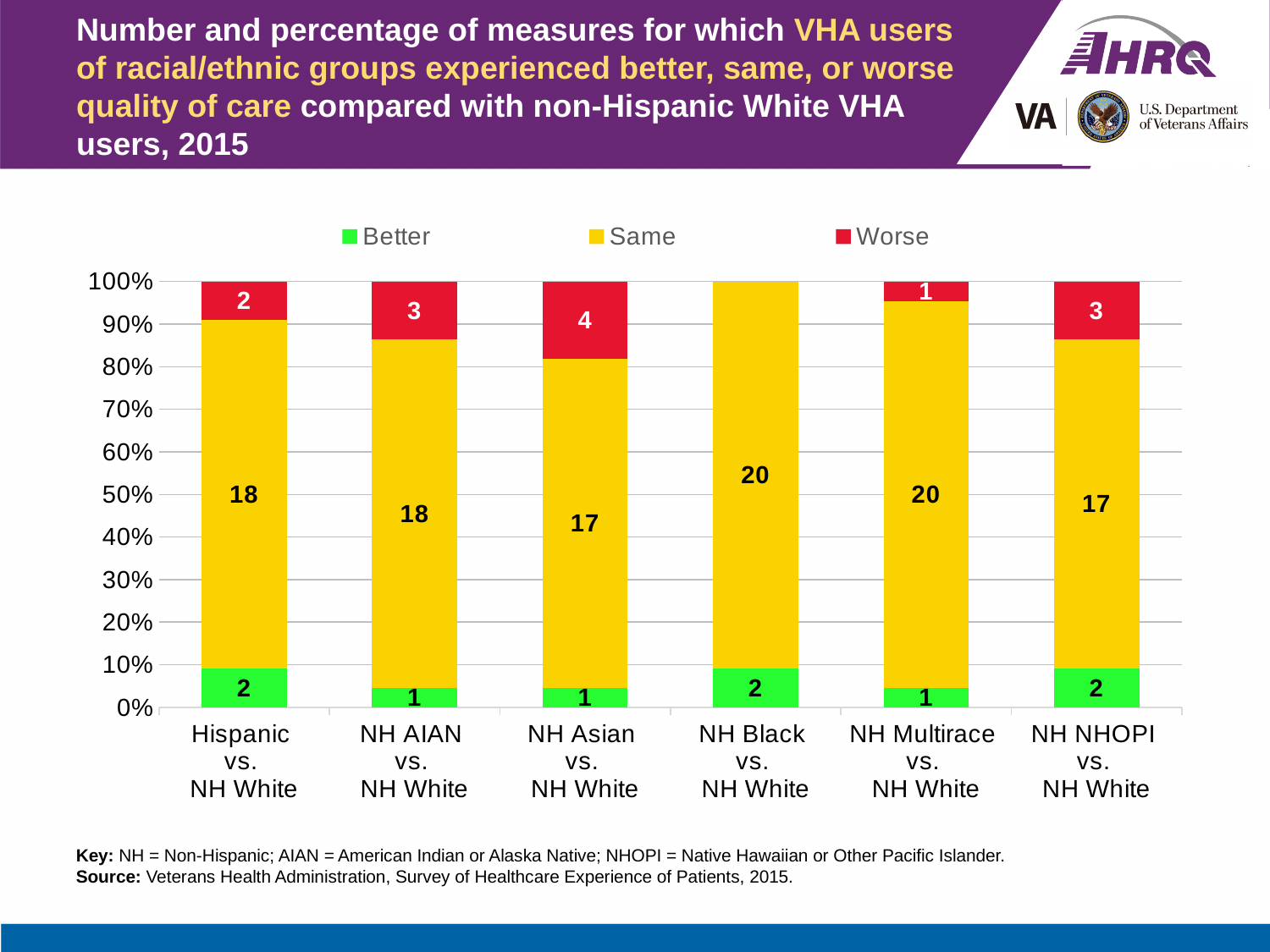
How many series does the legend list? 3 What is the difference between the "Worse" value for NH Asian vs. NH White and the "Worse" value for NH Multirace vs. NH White? 3 How many measures are labelled "Same" for NH Asian vs. NH White? 17 What is the "Worse" value for NH AIAN vs. NH White? 3 What is the "Same" value for NH Multirace vs. NH White? 20 What colour represents the "Worse" series in the legend? Red Which comparison group has the highest "Worse" value? NH Asian vs. NH White What is the "Better" value for Hispanic vs. NH White? 2 Which has the larger "Same" value: Hispanic vs. NH White or NH Asian vs. NH White? Hispanic vs. NH White What is the total number of measures for NH Asian vs. NH White (Better + Same + Worse)? 22 What kind of chart is shown on the slide? Stacked bar chart How many comparison groups are shown on the x axis? 6